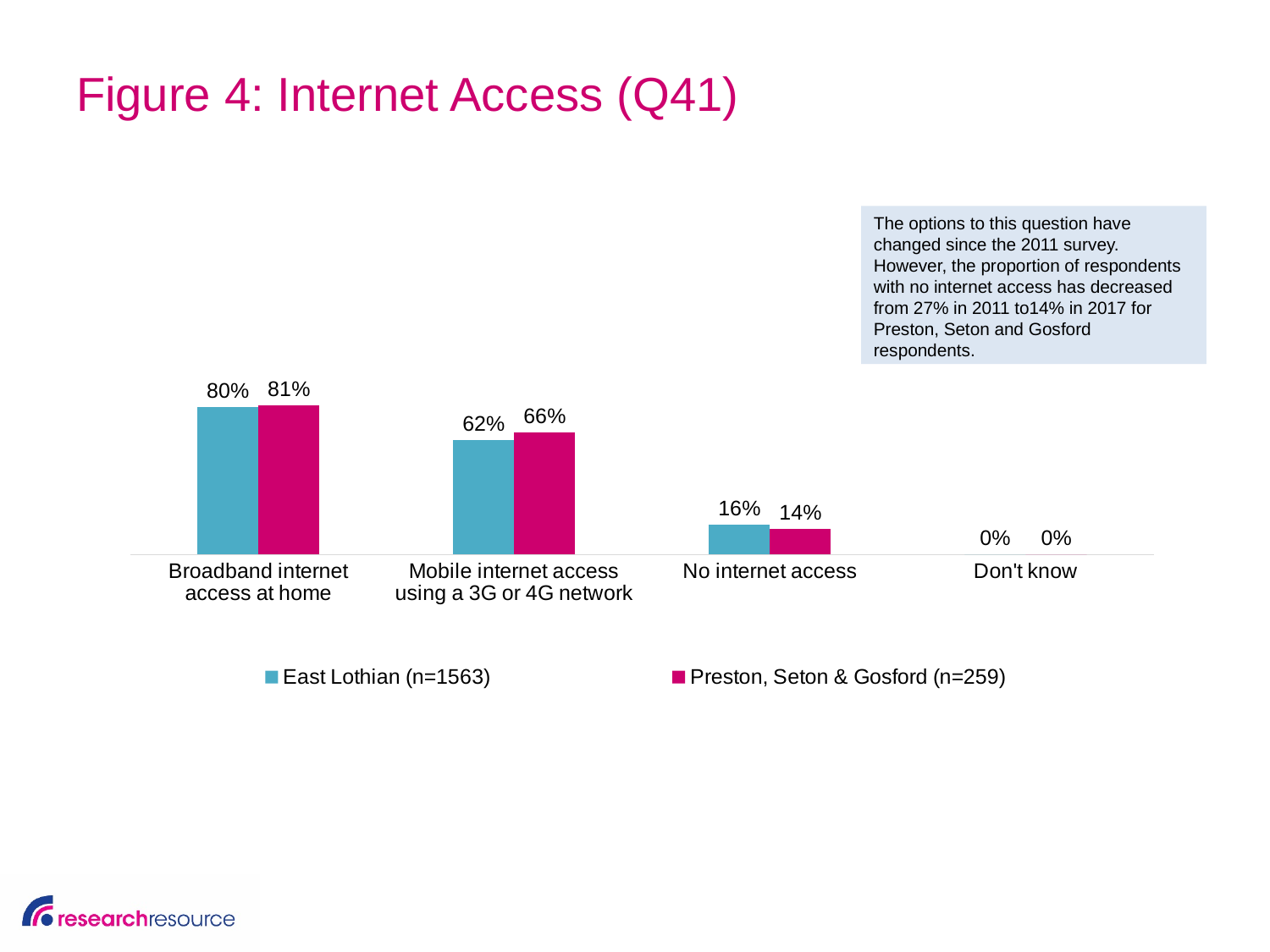
Which category has the highest value for East Lothian? Broadband internet access at home What is the sample size (n) shown in the legend for East Lothian? n=1563 What kind of chart is shown on the slide? Bar chart What is the value for Preston, Seton & Gosford for No internet access? 14% Which category has the lowest value for Preston, Seton & Gosford? Don't know How many categories are shown on the x axis? 4 How many series does the legend list? 2 What is the value for East Lothian for Broadband internet access at home? 80% What is the difference between the East Lothian and Preston, Seton & Gosford values for Mobile internet access using a 3G or 4G network? 4% What is the title of the chart? Figure 4: Internet Access (Q41) For No internet access, which series has the larger value: East Lothian or Preston, Seton & Gosford? East Lothian What is the value for Preston, Seton & Gosford for Mobile internet access using a 3G or 4G network? 66%